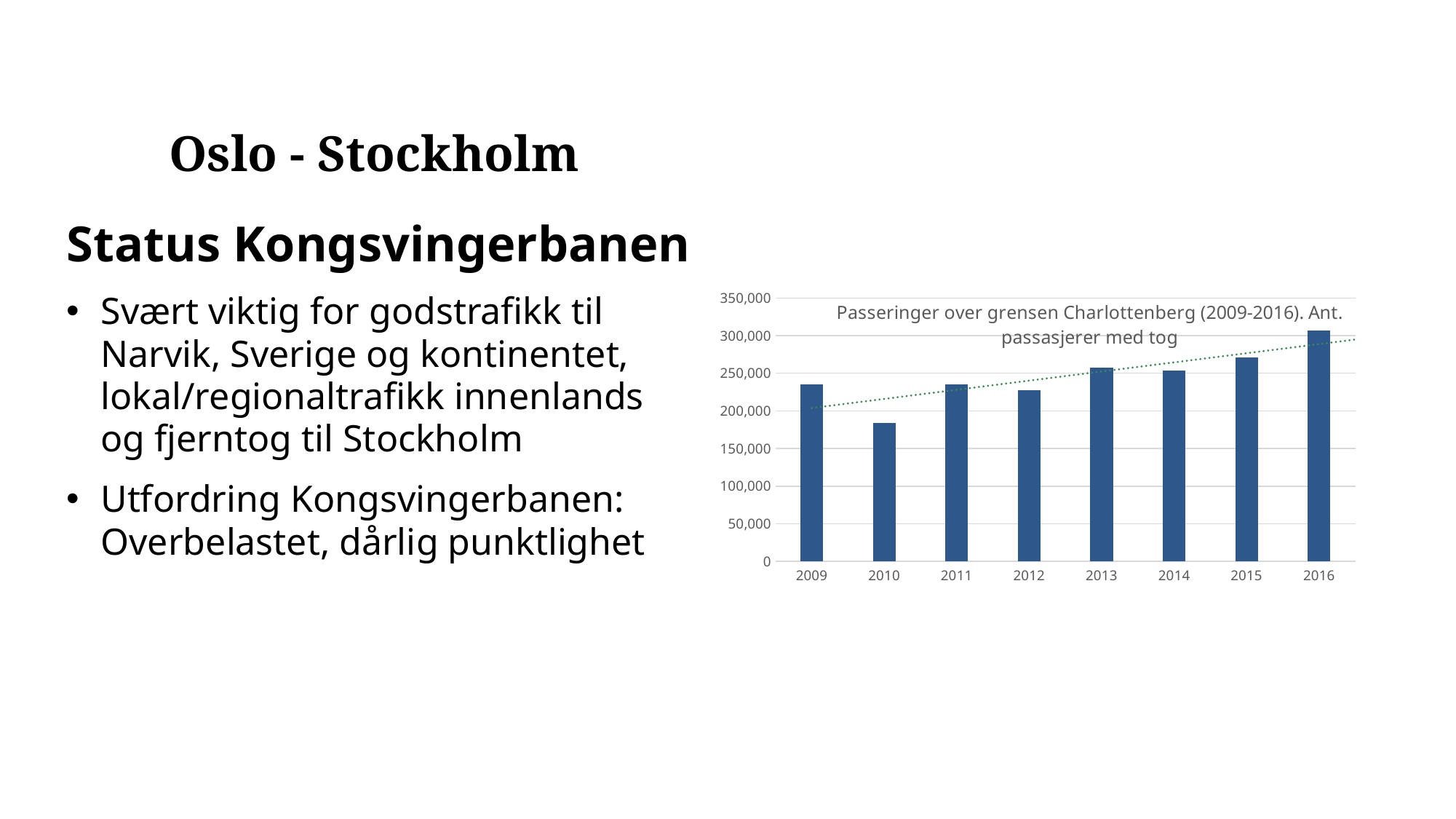
How many years are shown on the x axis of the chart? 8 Which is larger, the value for 2015 or the value for 2012? 2015 Is the value for 2010 greater or less than 200,000? less Is the value for 2016 greater or less than 300,000? greater Which year has the lowest bar in the chart? 2010 Do the values generally rise or fall from 2009 to 2016? rise Which is larger, the value for 2016 or the value for 2010? 2016 Is the value for 2012 greater or less than 250,000? less What is the title of the chart? Passeringer over grensen Charlottenberg (2009-2016). Ant. passasjerer med tog Which year has the highest bar in the chart? 2016 What kind of chart is shown on the slide? bar chart